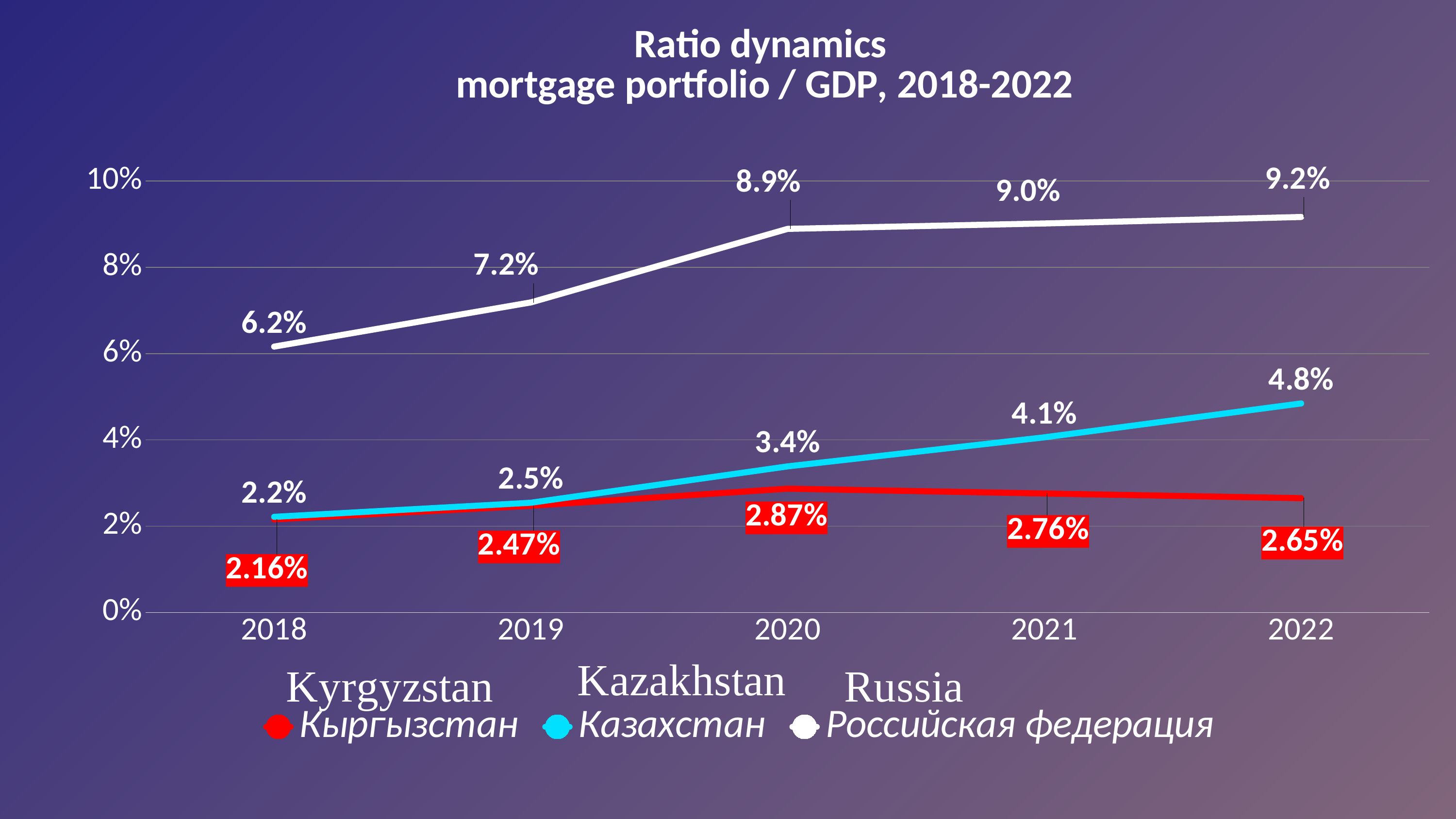
In which year is the value for Kyrgyzstan highest? 2020 What is the value for Kazakhstan in 2020? 3.4% What is the value for Russia in 2022? 9.2% Is the value for Russia in 2019 greater or less than 8%? less What kind of chart is shown on the slide? line chart What is the difference between the Russia values in 2022 and 2018? 3.0% Which is larger in 2022: the value for Kazakhstan or the value for Kyrgyzstan? Kazakhstan Does the value for Kazakhstan rise or fall from 2018 to 2022? rise How many years are shown on the x axis? 5 How many series does the legend list? 3 In which year is the value for Russia lowest? 2018 What is the value for Kyrgyzstan in 2019? 2.47%